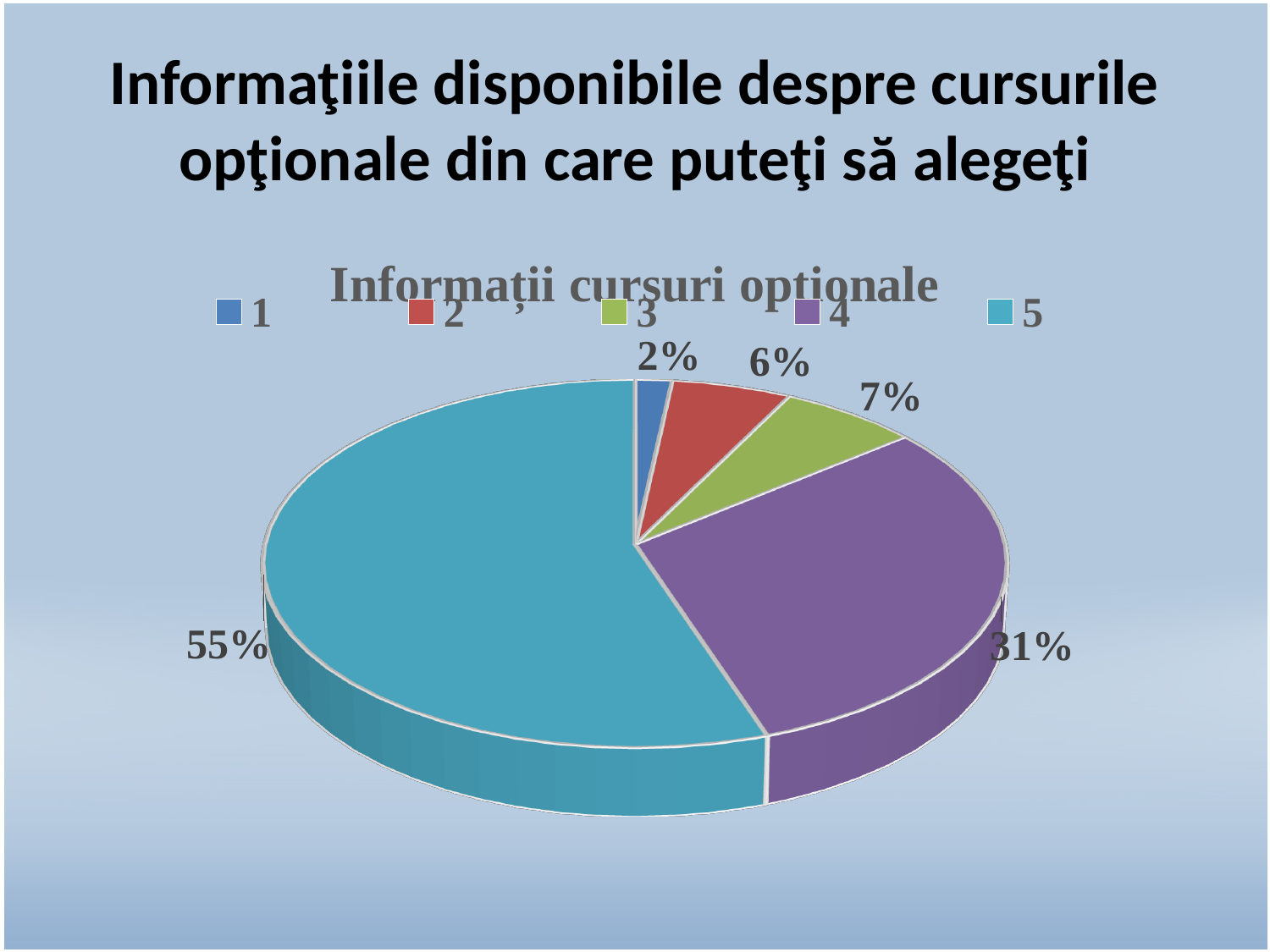
How many categories does the legend list? 5 What is the value for category 3? 7% What share of the pie does category 4 have? 31% What is the difference between the shares of category 5 and category 4? 24% Which is larger, the share of category 2 or category 3? 3 What is the value for category 2? 6% What is the value for category 1? 2% What share of the pie does category 5 have? 55% Which category has the largest slice? 5 What is the chart's title? Informații cursuri opționale Which category has the smallest slice? 1 What type of chart is shown on the slide? pie chart